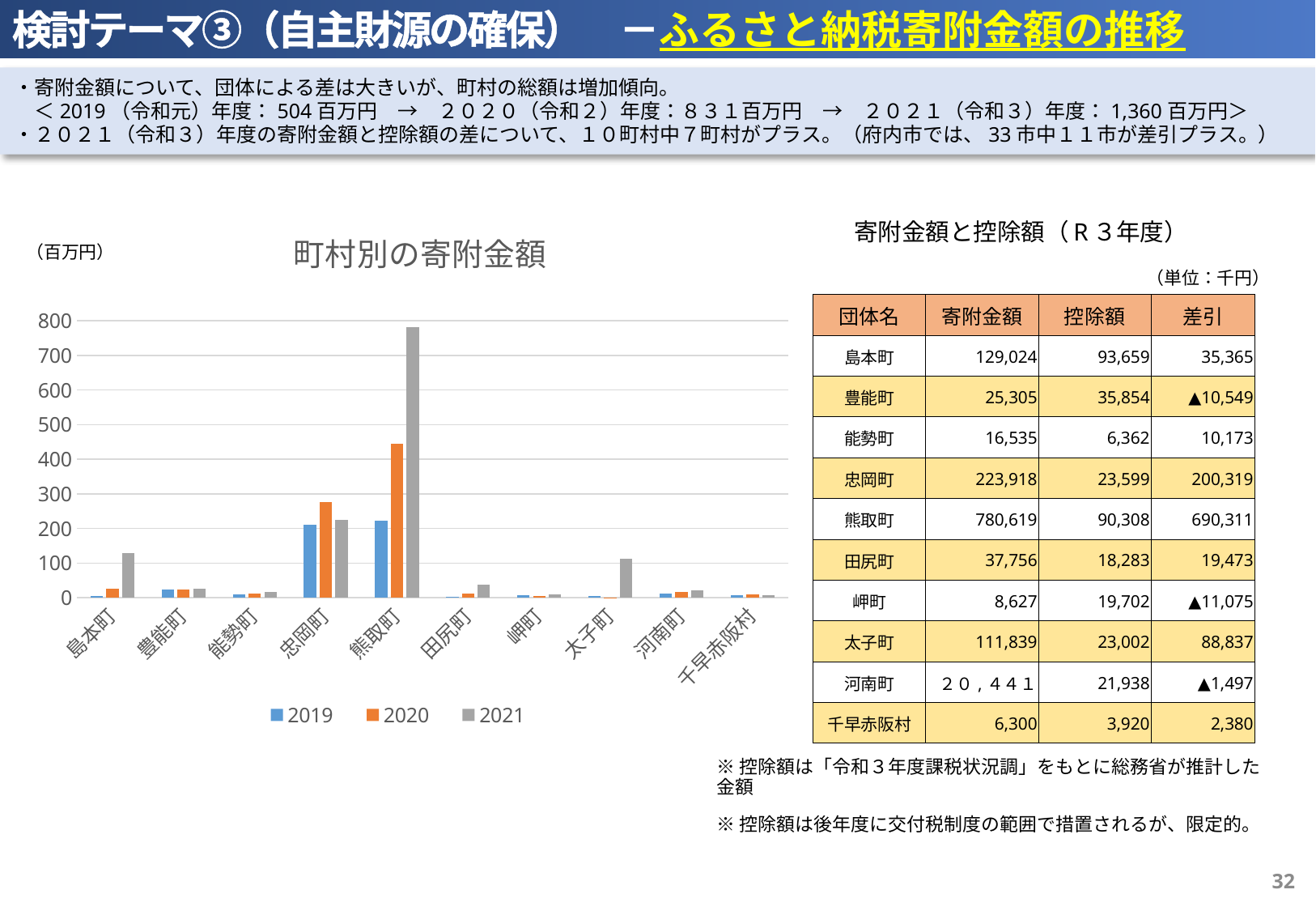
In the 町村別の寄附金額 chart, is the 2021 value for 太子町 greater or less than 200? less In the 町村別の寄附金額 chart, which colour represents the 2021 series? grey In the 町村別の寄附金額 chart, is the 2020 value for 忠岡町 greater or less than 300? less In the 町村別の寄附金額 chart, which municipality has the highest 2021 value? 熊取町 How many series does the legend of the 町村別の寄附金額 chart list? 3 In the 町村別の寄附金額 chart, is the 2021 value for 熊取町 greater or less than 700? greater How many municipalities (categories) are shown on the x axis of the 町村別の寄附金額 chart? 10 In the 町村別の寄附金額 chart, which is larger for 2021: 熊取町 or 忠岡町? 熊取町 In the 町村別の寄附金額 chart, do the values for 熊取町 rise or fall from 2019 to 2021? rise What type of chart is 町村別の寄附金額? bar chart What unit is shown for the values in the 町村別の寄附金額 chart? 百万円